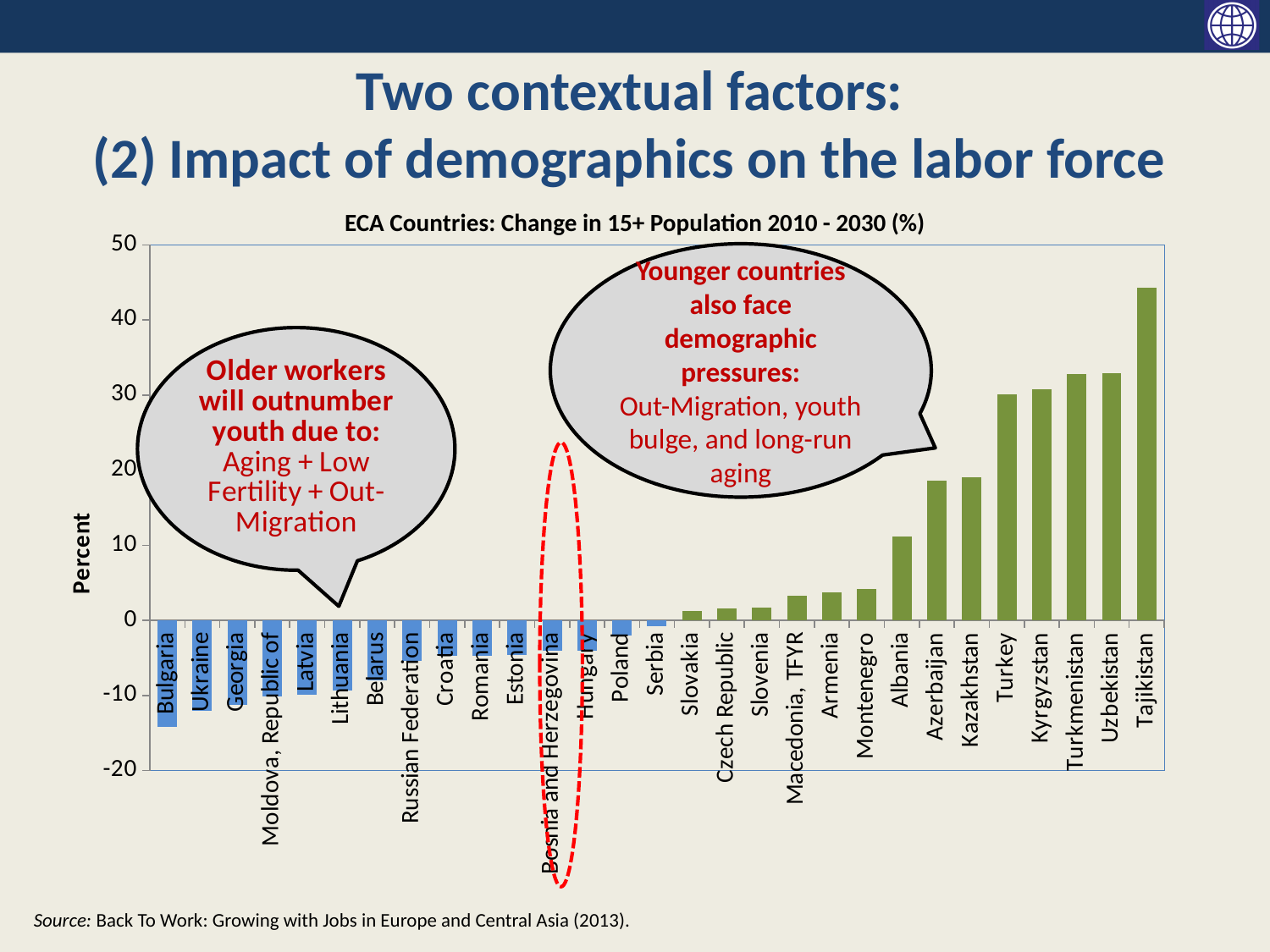
Which country has the highest change in 15+ population 2010-2030? Tajikistan What kind of chart is shown on the slide? Bar chart Is the value for Albania greater or less than 10? greater Is the value for Turkey greater or less than 20? greater How many countries are shown in the chart? 29 Is the value for Bulgaria greater or less than -10? less Which has a larger value, Poland or Bulgaria? Poland Which country has the lowest (most negative) change in 15+ population 2010-2030? Bulgaria Which has a larger value, Tajikistan or Turkey? Tajikistan Do the values rise or fall moving from left to right along the x axis? Rise Which country's bar is circled with a red dashed outline? Bosnia and Herzegovina